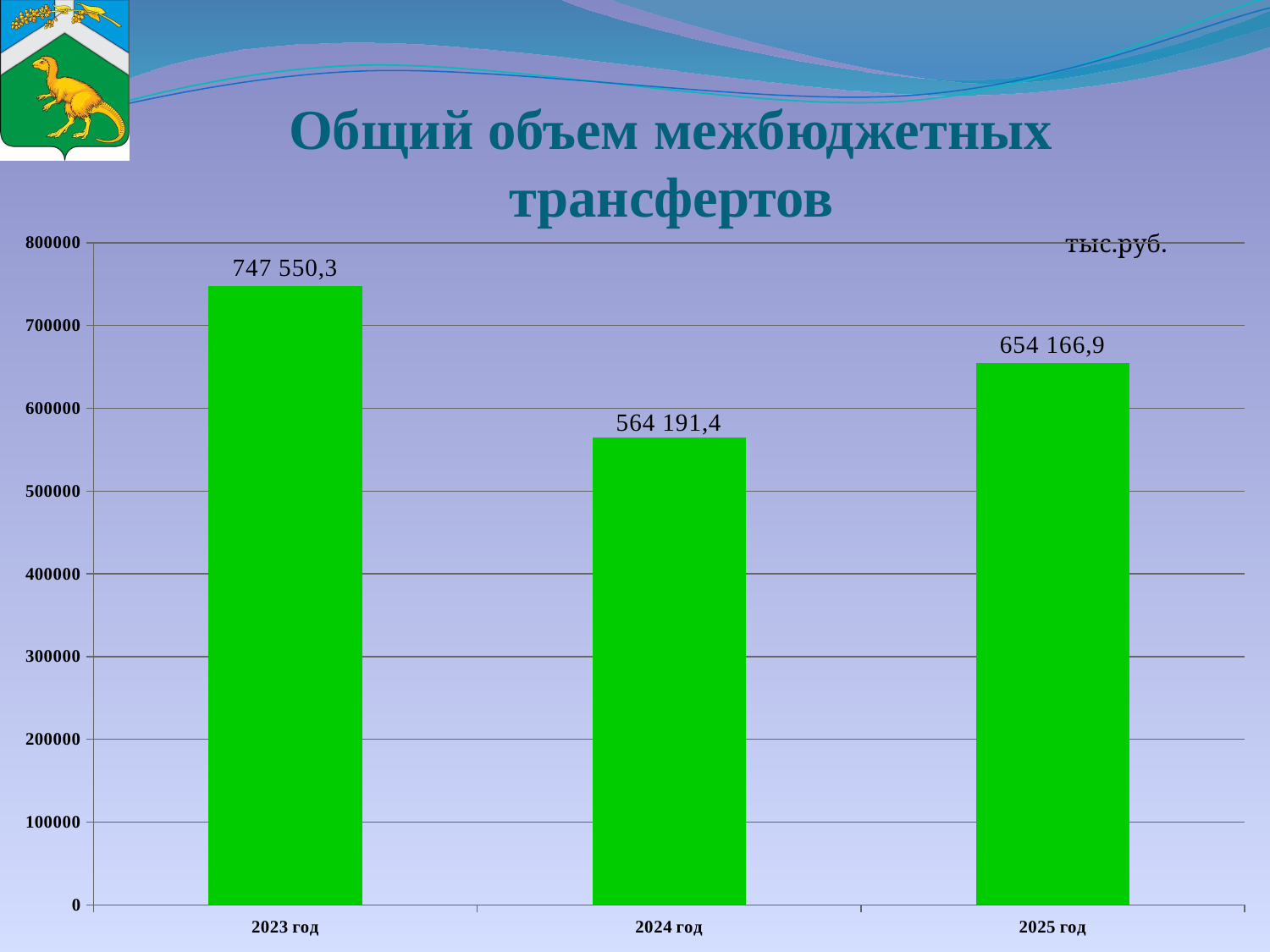
Which year has the highest value? 2023 год What is the title of the chart? Общий объем межбюджетных трансфертов Which year has the lowest value? 2024 год What is the difference between the values for 2023 год and 2024 год? 183 358,9 What kind of chart is shown on the slide? bar chart How many years are shown on the chart? 3 What is the value for 2023 год? 747 550,3 Is the value for 2024 год greater or less than 600000? less What is the difference between the values for 2025 год and 2024 год? 89 975,5 What is the value for 2025 год? 654 166,9 Which is larger, the value for 2025 год or the value for 2024 год? 2025 год What is the value for 2024 год? 564 191,4